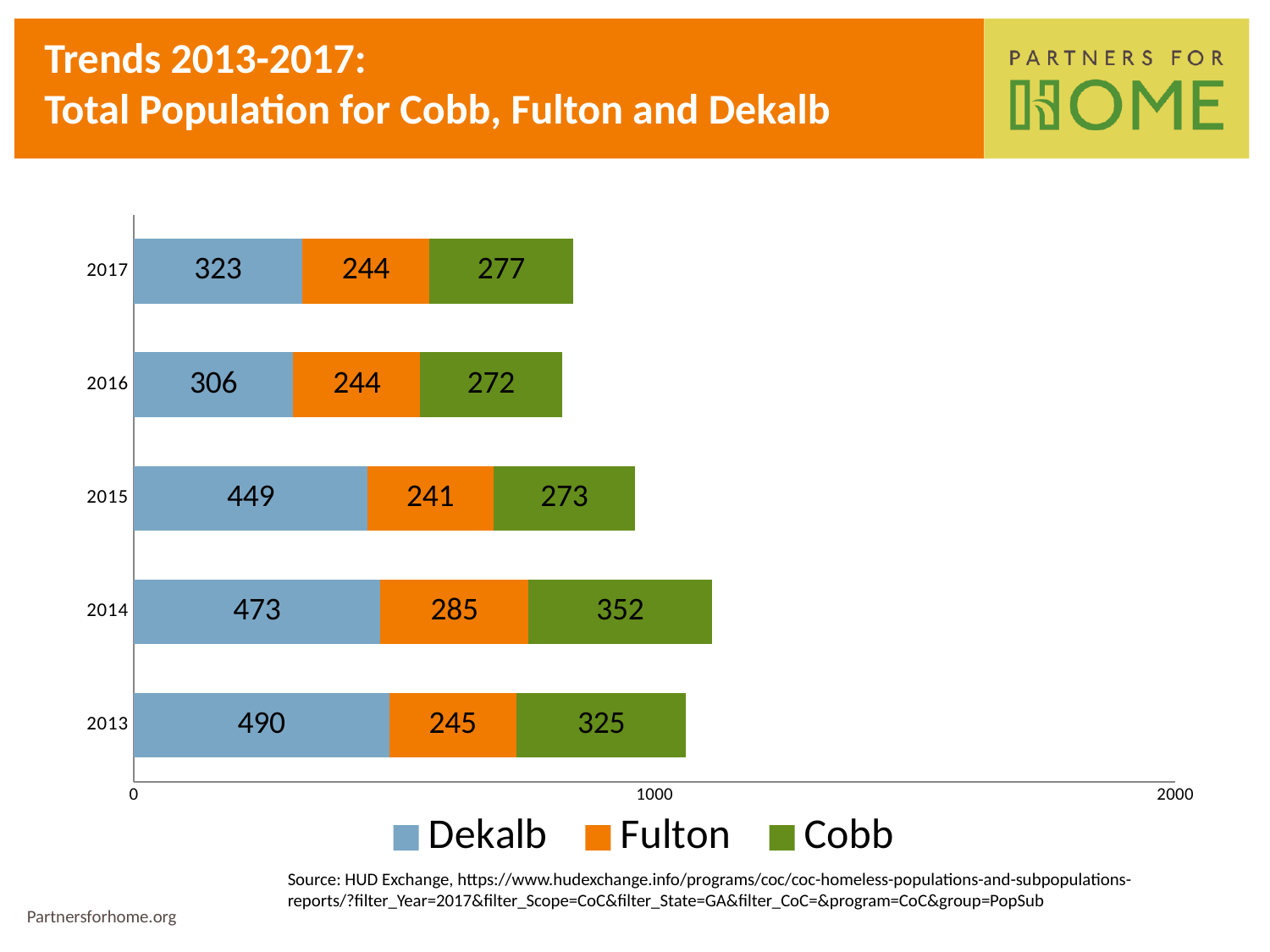
What is the Cobb value for 2014? 352 How many years are shown on the chart? 5 What is the total of the stacked bar for 2017? 844 How many series does the legend list? 3 What kind of chart is shown on the slide? Stacked bar chart What is the Fulton value for 2015? 241 Which is larger, the Cobb value for 2013 or the Cobb value for 2016? 2013 What is the Dekalb value for 2017? 323 Is the total length of the 2014 bar greater or less than 1000? greater In which year is the Dekalb value highest? 2013 What is the difference between the Dekalb values for 2013 and 2017? 167 In which year is the Fulton value lowest? 2015